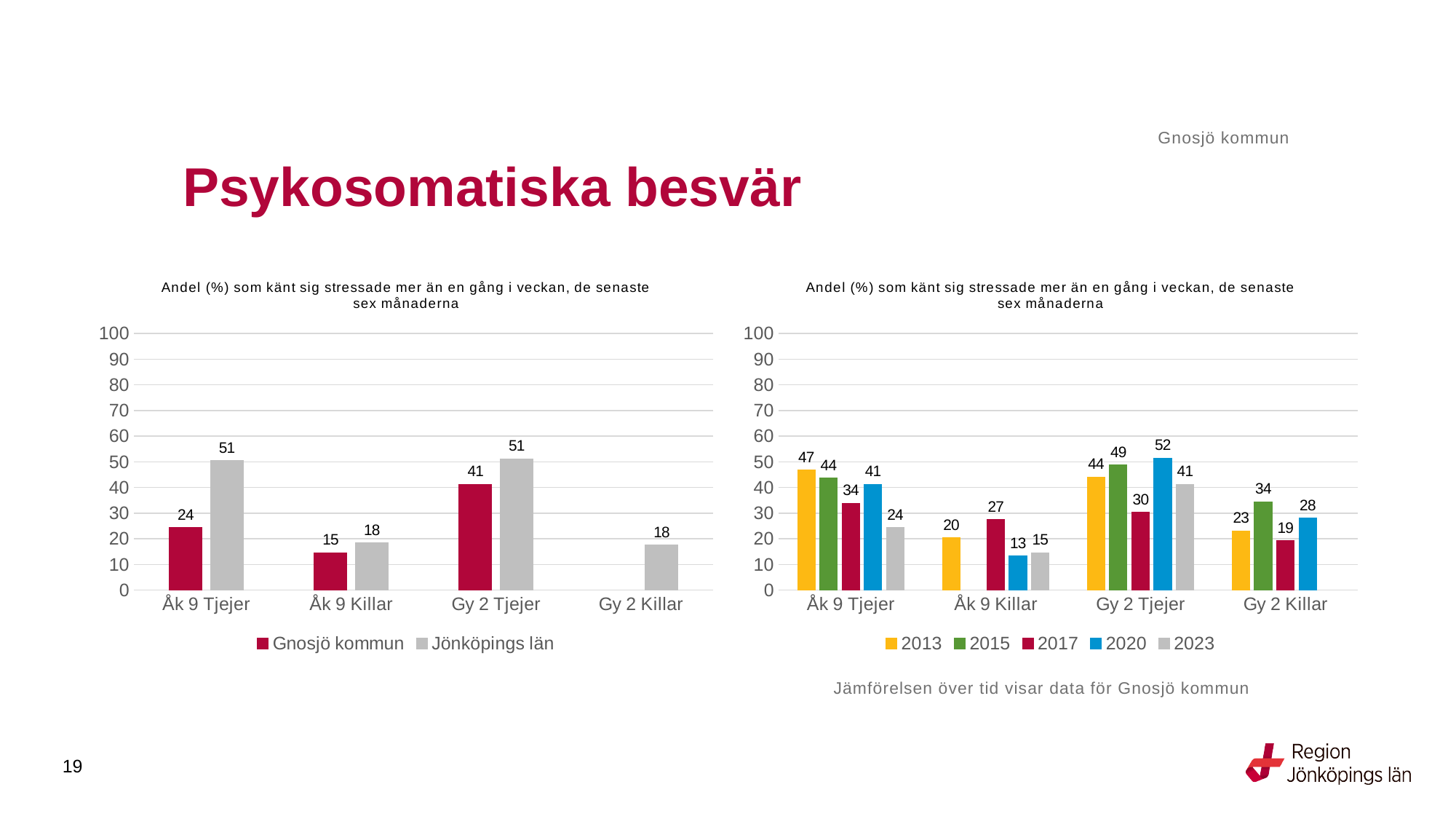
In the right chart, what is the value for 2017 for Åk 9 Killar? 27 In the right chart, how many series does the legend list? 5 In the right chart, which year has the highest value for Gy 2 Killar? 2015 In the left chart, what is the difference between Jönköpings län and Gnosjö kommun for Åk 9 Tjejer? 27 In the right chart, is the value for 2013 or 2023 larger for Åk 9 Tjejer? 2013 In the left chart, what is the value for Gnosjö kommun for Åk 9 Tjejer? 24 In the left chart, how many series does the legend list? 2 In the right chart, which year has the lowest value for Åk 9 Killar? 2020 In the left chart, what is the value for Jönköpings län for Gy 2 Killar? 18 In the right chart, what is the value for 2020 for Gy 2 Tjejer? 52 In the left chart, which category has the lowest value for Gnosjö kommun among those with a bar shown? Åk 9 Killar What kind of chart is the right chart? Bar chart